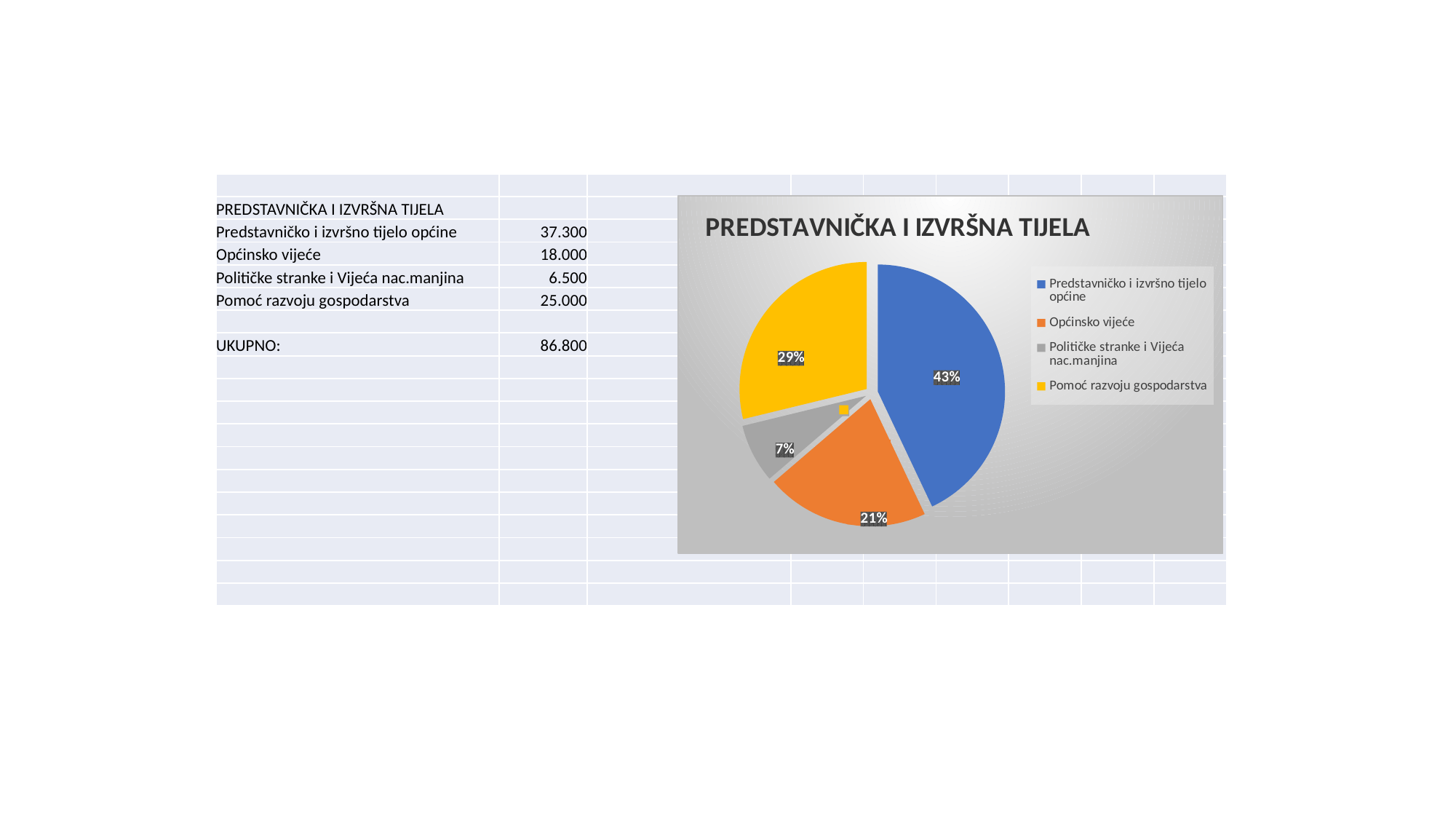
Which category has the smallest slice of the pie? Političke stranke i Vijeća nac.manjina What share of the pie does Predstavničko i izvršno tijelo općine have? 43% How many slices does the pie chart have? 4 What share of the pie does Općinsko vijeće have? 21% What kind of chart is shown on the slide? pie chart Which category has the largest slice of the pie? Predstavničko i izvršno tijelo općine How many entries does the legend list? 4 What share of the pie does Političke stranke i Vijeća nac.manjina have? 7% Which slice is larger, Općinsko vijeće or Pomoć razvoju gospodarstva? Pomoć razvoju gospodarstva What colour is the slice for Pomoć razvoju gospodarstva? yellow What is the title of the chart? PREDSTAVNIČKA I IZVRŠNA TIJELA